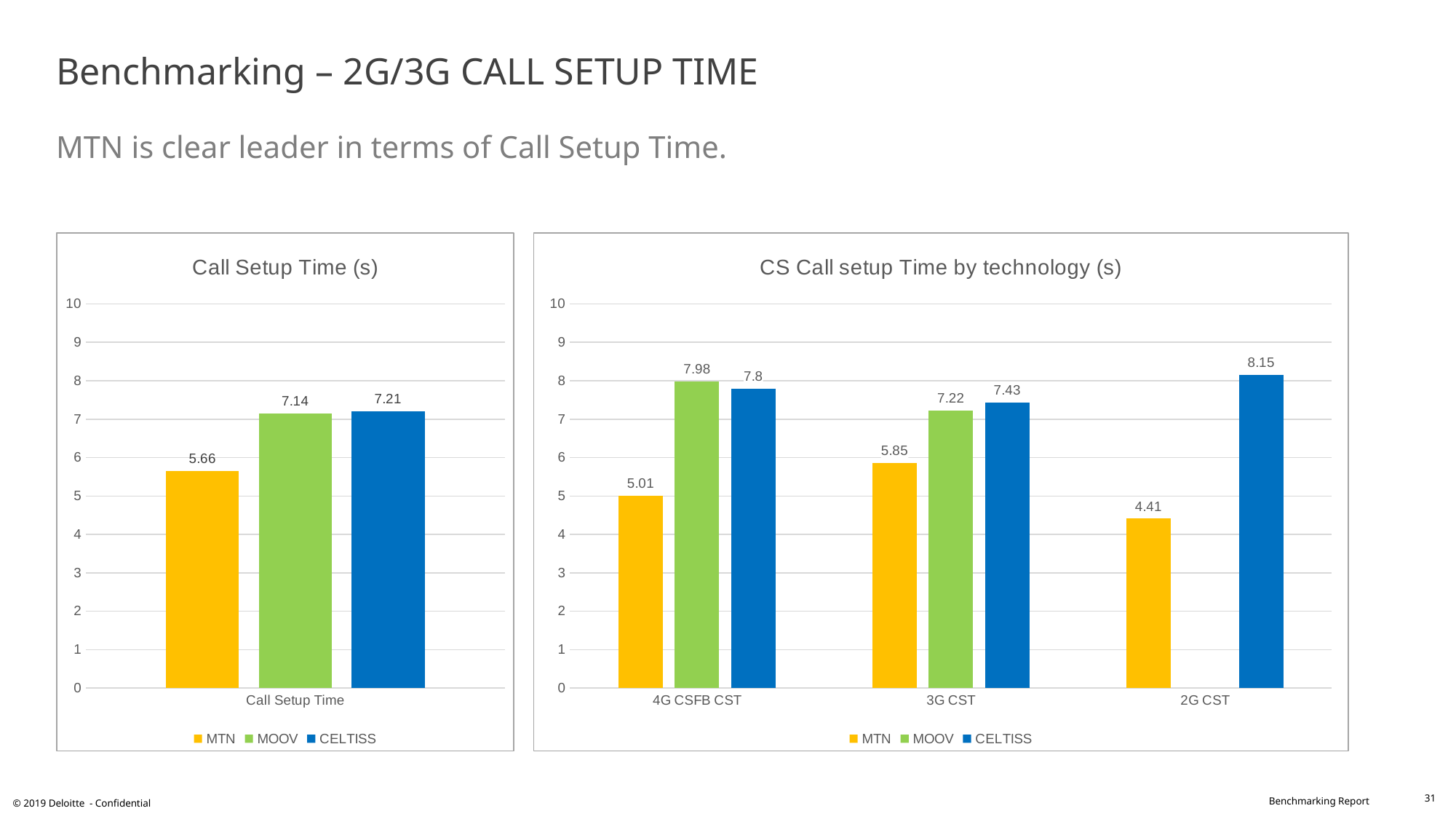
In the 'CS Call setup Time by technology (s)' chart, what is the value for MOOV at 4G CSFB CST? 7.98 In the 'CS Call setup Time by technology (s)' chart, which is larger at 3G CST: MOOV or CELTISS? CELTISS In the 'Call Setup Time (s)' chart, what is the difference between CELTISS and MTN? 1.55 In the 'CS Call setup Time by technology (s)' chart, which colour represents MTN? Yellow What kind of chart is the 'CS Call setup Time by technology (s)' chart? Bar chart In the 'Call Setup Time (s)' chart, how many series does the legend list? 3 In the 'Call Setup Time (s)' chart, what is the value for MTN? 5.66 In the 'CS Call setup Time by technology (s)' chart, which bar has the lowest value? MTN at 2G CST In the 'CS Call setup Time by technology (s)' chart, what is the value for CELTISS at 2G CST? 8.15 In the 'CS Call setup Time by technology (s)' chart, how many technology categories are shown on the x axis? 3 In the 'CS Call setup Time by technology (s)' chart, what is the difference between CELTISS and MTN at 3G CST? 1.58 In the 'Call Setup Time (s)' chart, which operator has the highest call setup time? CELTISS